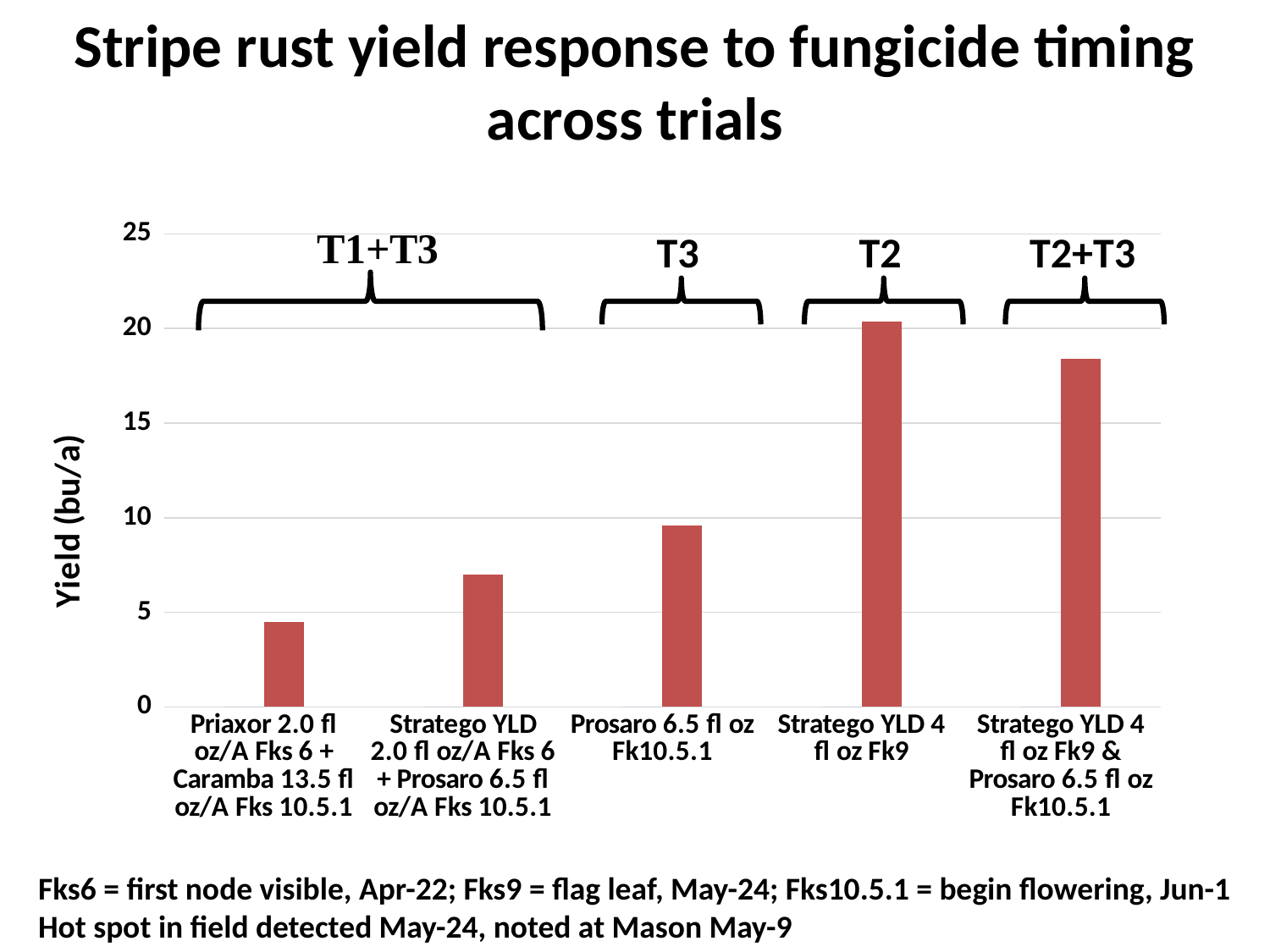
Which treatment has the lowest yield response? Priaxor 2.0 fl oz/A Fks 6 + Caramba 13.5 fl oz/A Fks 10.5.1 Is the yield for Stratego YLD 4 fl oz Fk9 & Prosaro 6.5 fl oz Fk10.5.1 greater or less than 20 bu/a? less Is the yield for Priaxor 2.0 fl oz/A Fks 6 + Caramba 13.5 fl oz/A Fks 10.5.1 greater or less than 5 bu/a? less Which has the larger yield response: the T2 treatment (Stratego YLD 4 fl oz Fk9) or the T2+T3 treatment (Stratego YLD 4 fl oz Fk9 & Prosaro 6.5 fl oz Fk10.5.1)? Stratego YLD 4 fl oz Fk9 Is the yield for Stratego YLD 4 fl oz Fk9 greater or less than 15 bu/a? greater Which has the larger yield response: Prosaro 6.5 fl oz Fk10.5.1 or Stratego YLD 2.0 fl oz/A Fks 6 + Prosaro 6.5 fl oz/A Fks 10.5.1? Prosaro 6.5 fl oz Fk10.5.1 What kind of chart is shown on the slide? bar chart Which timing group label is shown above the first two bars? T1+T3 What is the label on the vertical axis of the chart? Yield (bu/a) Which treatment has the highest yield response? Stratego YLD 4 fl oz Fk9 How many bars (treatments) are plotted in the chart? 5